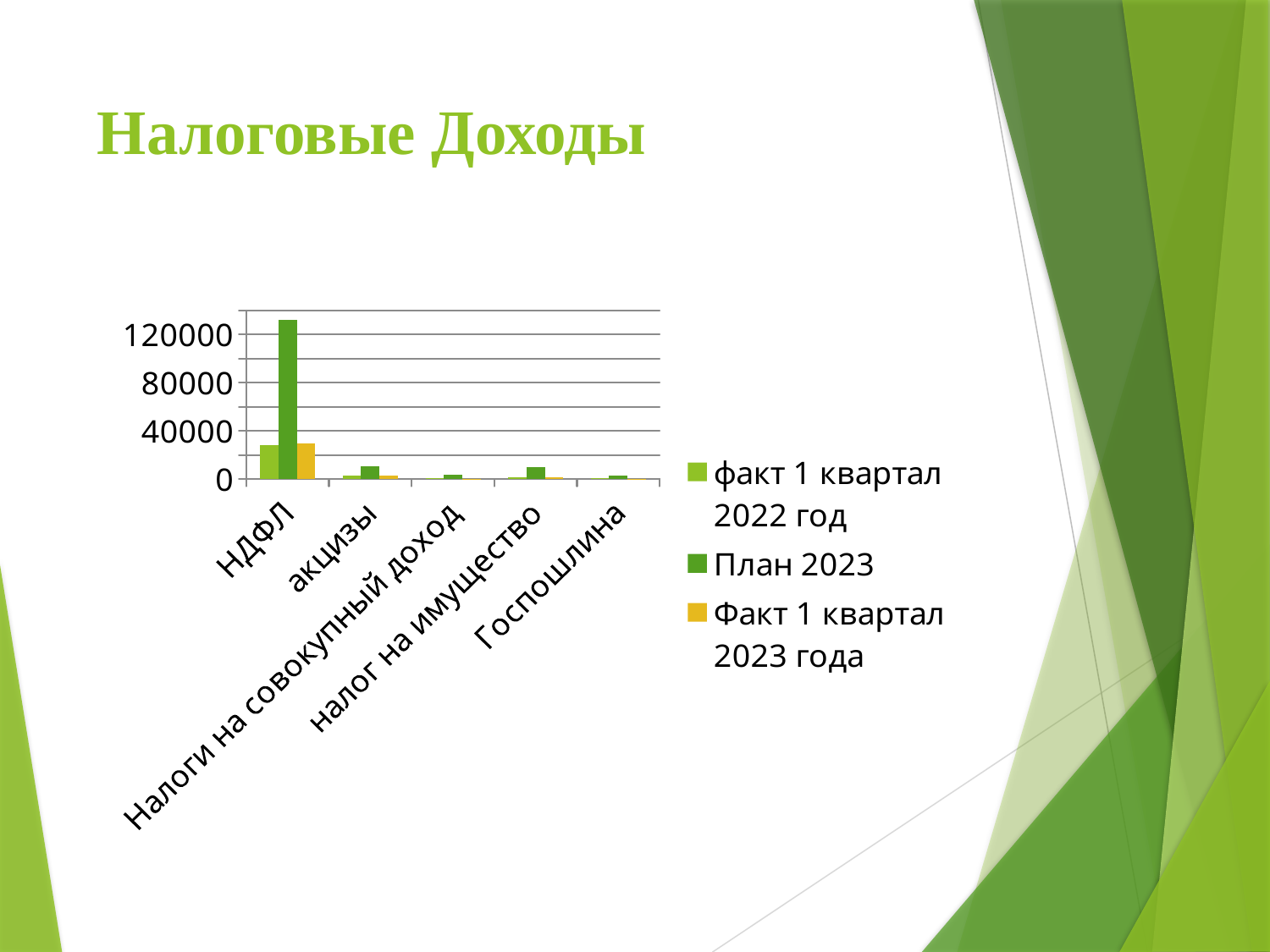
Is the value of План 2023 for НДФЛ greater or less than 120000? greater Is the value of План 2023 for акцизы greater or less than 40000? less What is the title of the slide containing the chart? Налоговые Доходы Which series is shown in yellow in the chart legend? Факт 1 квартал 2023 года What kind of chart is shown on the slide? bar chart How many series does the chart legend list? 3 For the category НДФЛ, which is larger: План 2023 or Факт 1 квартал 2023 года? План 2023 How many categories are shown on the x axis of the chart? 5 Is the value of факт 1 квартал 2022 год for НДФЛ greater or less than 40000? less Which series has the tallest bar in the chart? План 2023 Which category has the highest value for the series План 2023? НДФЛ For the series План 2023, which is larger: the value for НДФЛ or the value for Госпошлина? НДФЛ